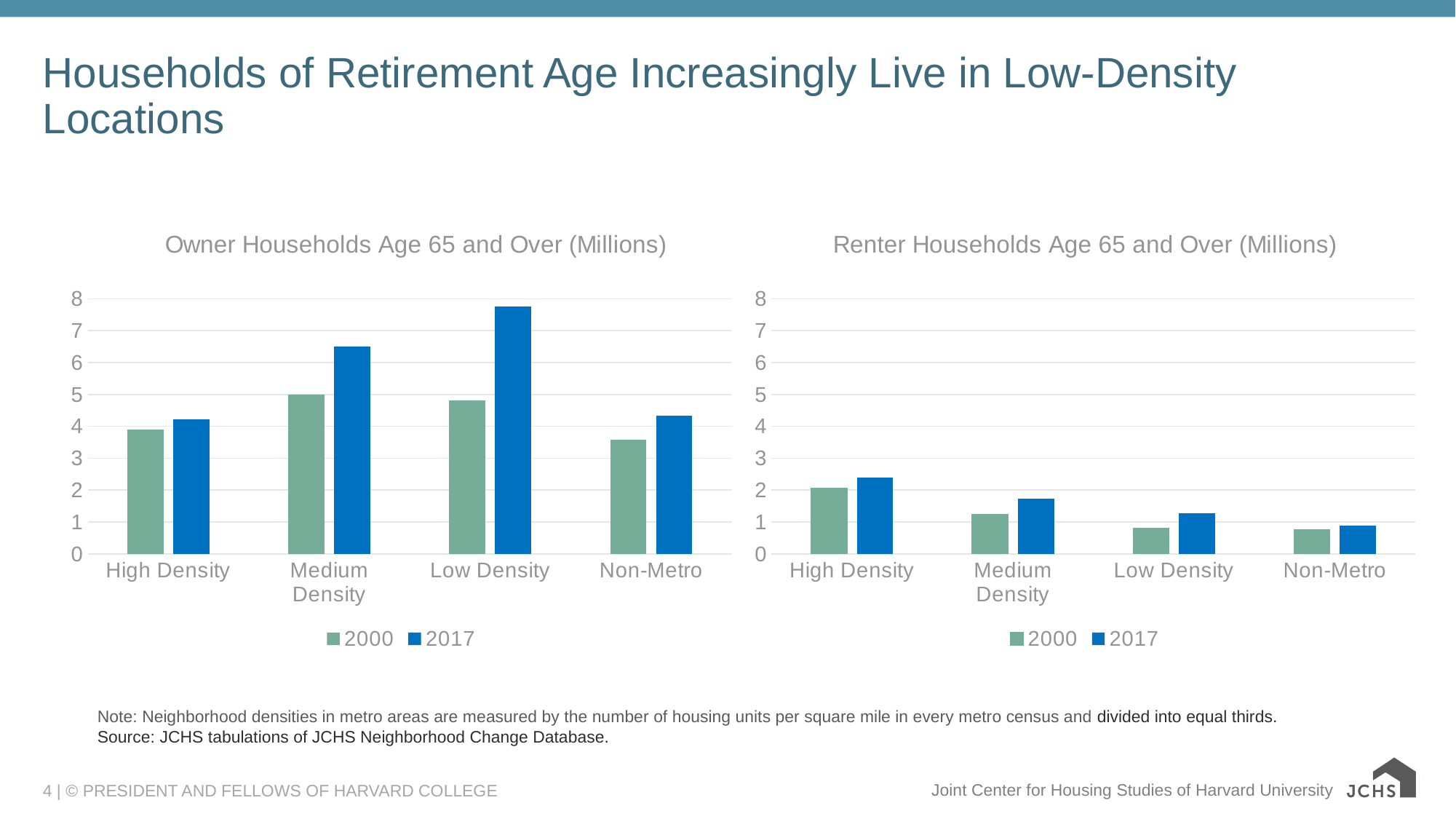
In the Renter Households Age 65 and Over chart, is the 2000 value for Low Density greater or less than 1? less How many density categories are shown on the x axis of the Owner Households Age 65 and Over chart? 4 In the Renter Households Age 65 and Over chart, do the 2017 values rise or fall moving from High Density to Non-Metro along the x axis? fall Which colour represents the 2017 series in the Owner Households Age 65 and Over chart? blue How many series does the legend of the Renter Households Age 65 and Over chart list? 2 In the Owner Households Age 65 and Over chart, which is larger for 2017: Low Density or Medium Density? Low Density In the Owner Households Age 65 and Over chart, is the 2017 value for Medium Density greater or less than 6? greater In the Owner Households Age 65 and Over chart, is the 2017 value for Low Density greater or less than 7? greater What kind of chart is the Owner Households Age 65 and Over chart? bar chart In the Renter Households Age 65 and Over chart, which category has the highest value for 2017? High Density In the Renter Households Age 65 and Over chart, which category has the highest value for 2000? High Density In the Owner Households Age 65 and Over chart, which category has the highest value for 2017? Low Density